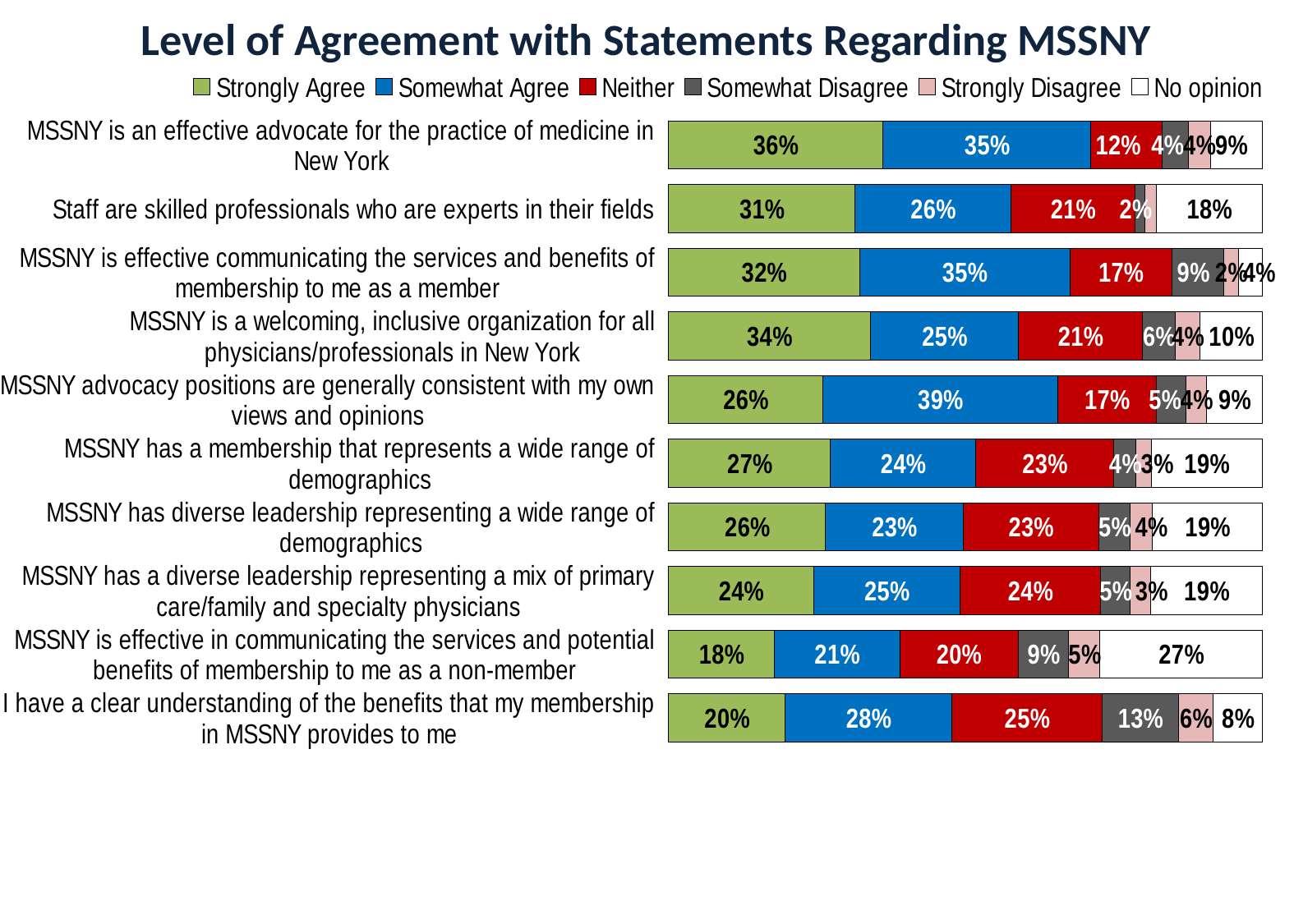
What percentage somewhat disagree that they have a clear understanding of the benefits that their membership in MSSNY provides? 13% Which statement has the highest Strongly Agree percentage? MSSNY is an effective advocate for the practice of medicine in New York Which statement has the lowest Strongly Agree percentage? MSSNY is effective in communicating the services and potential benefits of membership to me as a non-member What percentage answered Neither for the statement that staff are skilled professionals who are experts in their fields? 21% Which is larger: the Somewhat Agree share for 'MSSNY advocacy positions are generally consistent with my own views and opinions' or for 'MSSNY has diverse leadership representing a wide range of demographics'? MSSNY advocacy positions are generally consistent with my own views and opinions How many response categories does the legend list? 6 How many statements are shown in the chart? 10 What percentage strongly agree that MSSNY is an effective advocate for the practice of medicine in New York? 36% What type of chart is shown on the slide? Stacked bar chart What percentage have no opinion on the statement that MSSNY is effective in communicating the services and potential benefits of membership to me as a non-member? 27% What is the difference in percentage points between the highest Strongly Agree value (36%) and the lowest Strongly Agree value (18%)? 18 percentage points Which statement has the highest Somewhat Agree percentage? MSSNY advocacy positions are generally consistent with my own views and opinions